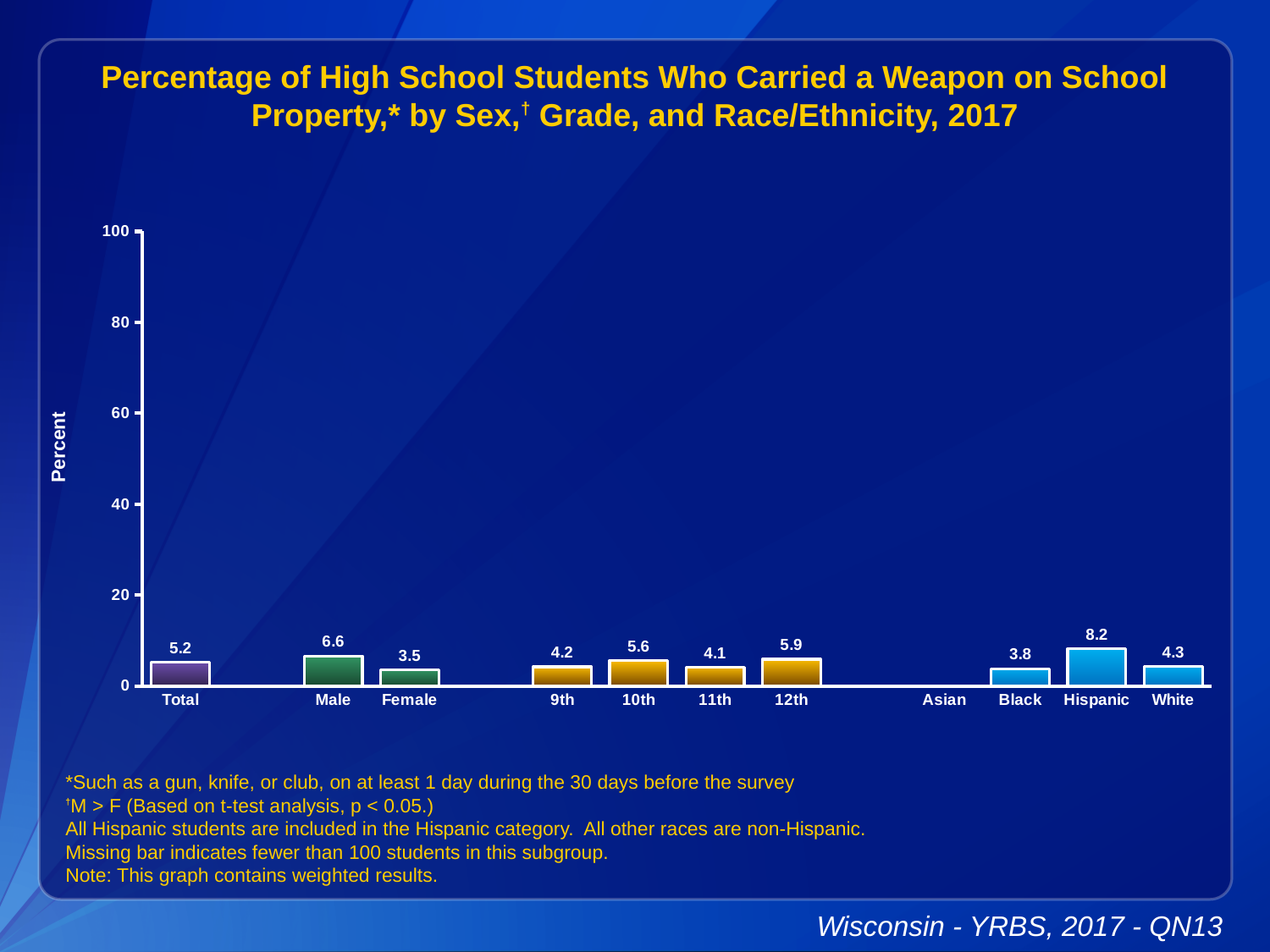
Which is larger, the value for 10th grade or 11th grade? 10th What is the difference between the Male and Female values? 3.1 What kind of chart is shown? bar chart What is the value for Total? 5.2 Is the value for 12th grade greater or less than 20? less What is the value for 11th grade? 4.1 What percentage of Male students carried a weapon on school property? 6.6 How many bars are plotted on the chart? 10 Among the plotted bars, which category has the lowest value? Female What is the difference between the Hispanic and Black values? 4.4 What is the value for Hispanic students? 8.2 Which category has the highest value? Hispanic